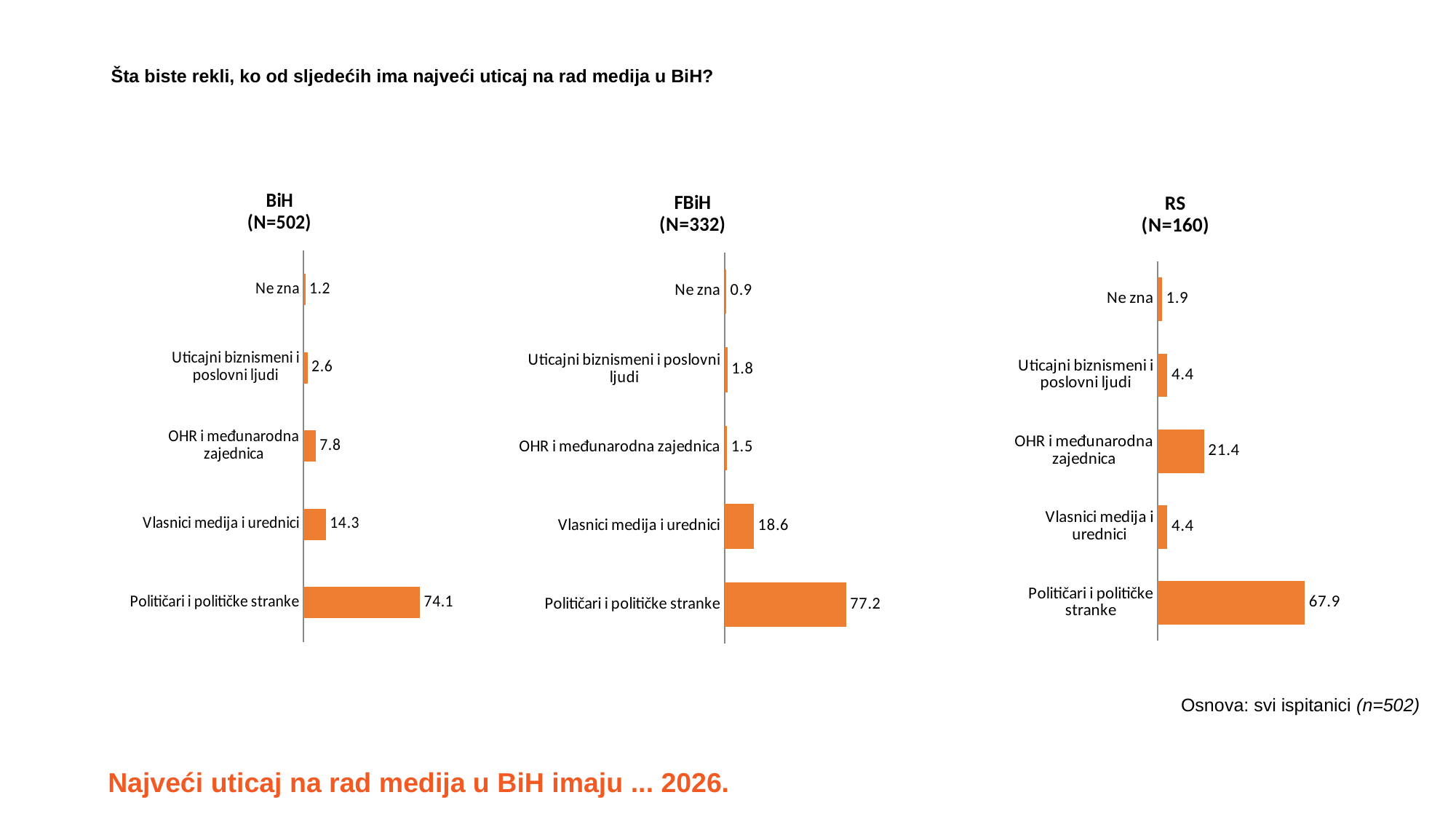
In the BiH (N=502) chart, what is the value for Političari i političke stranke? 74.1 In the RS (N=160) chart, what is the value for OHR i međunarodna zajednica? 21.4 In the FBiH (N=332) chart, which is larger: Uticajni biznismeni i poslovni ljudi or OHR i međunarodna zajednica? Uticajni biznismeni i poslovni ljudi In the BiH (N=502) chart, what is the difference between Vlasnici medija i urednici and OHR i međunarodna zajednica? 6.5 How many categories are shown in the BiH (N=502) chart? 5 In the FBiH (N=332) chart, what is the value for Vlasnici medija i urednici? 18.6 How many charts are shown on the slide? 3 What kind of chart is the RS (N=160) chart? Bar chart In the FBiH (N=332) chart, which category has the lowest value? Ne zna Which is larger: the value for Vlasnici medija i urednici in the FBiH (N=332) chart or in the RS (N=160) chart? FBiH (N=332) In the RS (N=160) chart, which category has the highest value? Političari i političke stranke In the RS (N=160) chart, what is the difference between Političari i političke stranke and OHR i međunarodna zajednica? 46.5